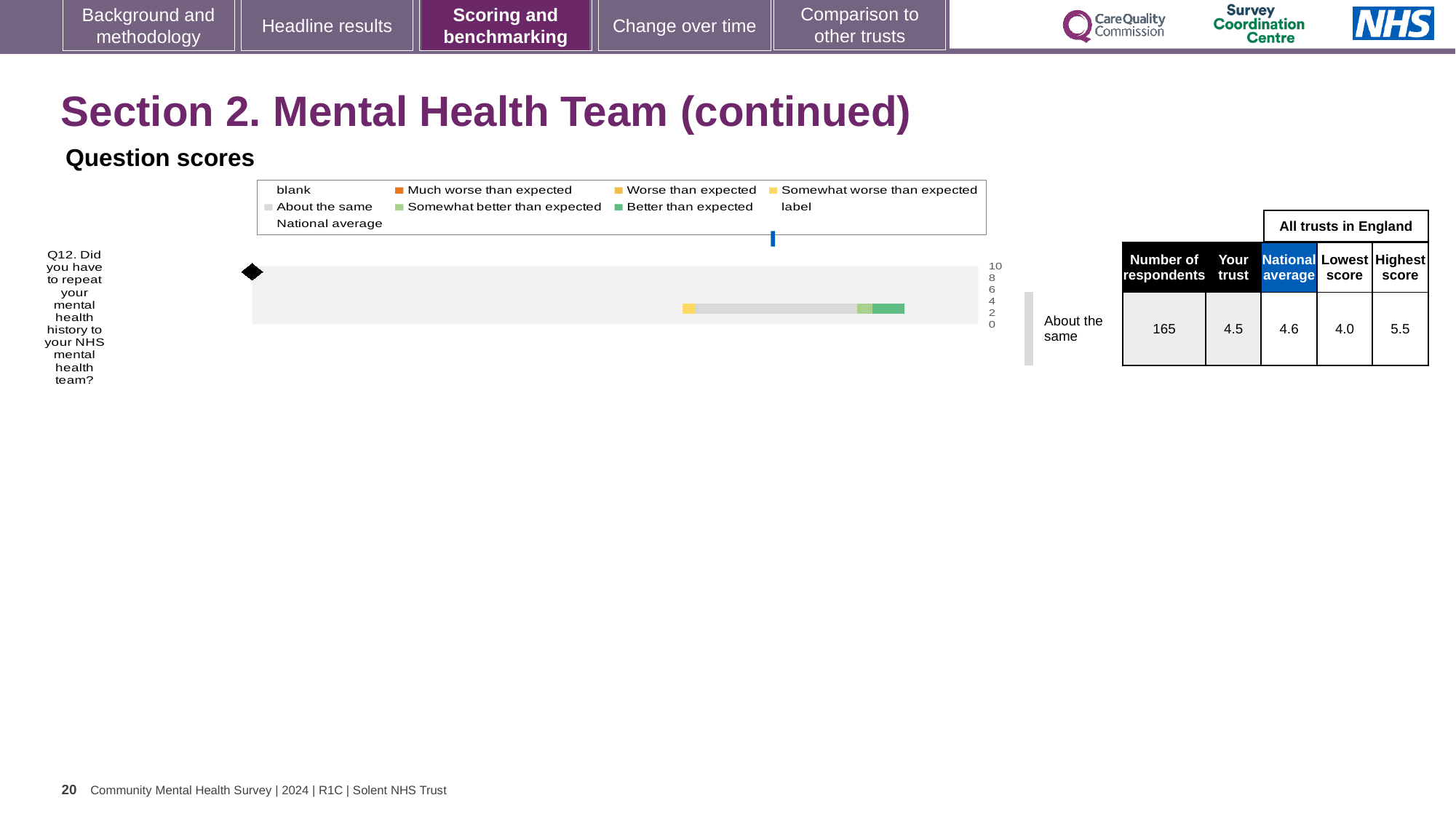
What is the 'Your trust' score for Q12? 4.5 What is the difference between the highest and lowest scores for Q12? 1.5 What is the highest score among all trusts in England for Q12? 5.5 How many survey questions are plotted in the chart? 1 What is the national average score for Q12? 4.6 What is the difference between the national average and the 'Your trust' score for Q12? 0.1 Which question is plotted in the chart? Q12. Did you have to repeat your mental health history to your NHS mental health team? What is the benchmark category shown for Q12? About the same What kind of chart is shown under 'Question scores'? bar chart What is the lowest score among all trusts in England for Q12? 4.0 Which is larger for Q12, the 'Your trust' score or the national average? national average How many respondents answered Q12? 165